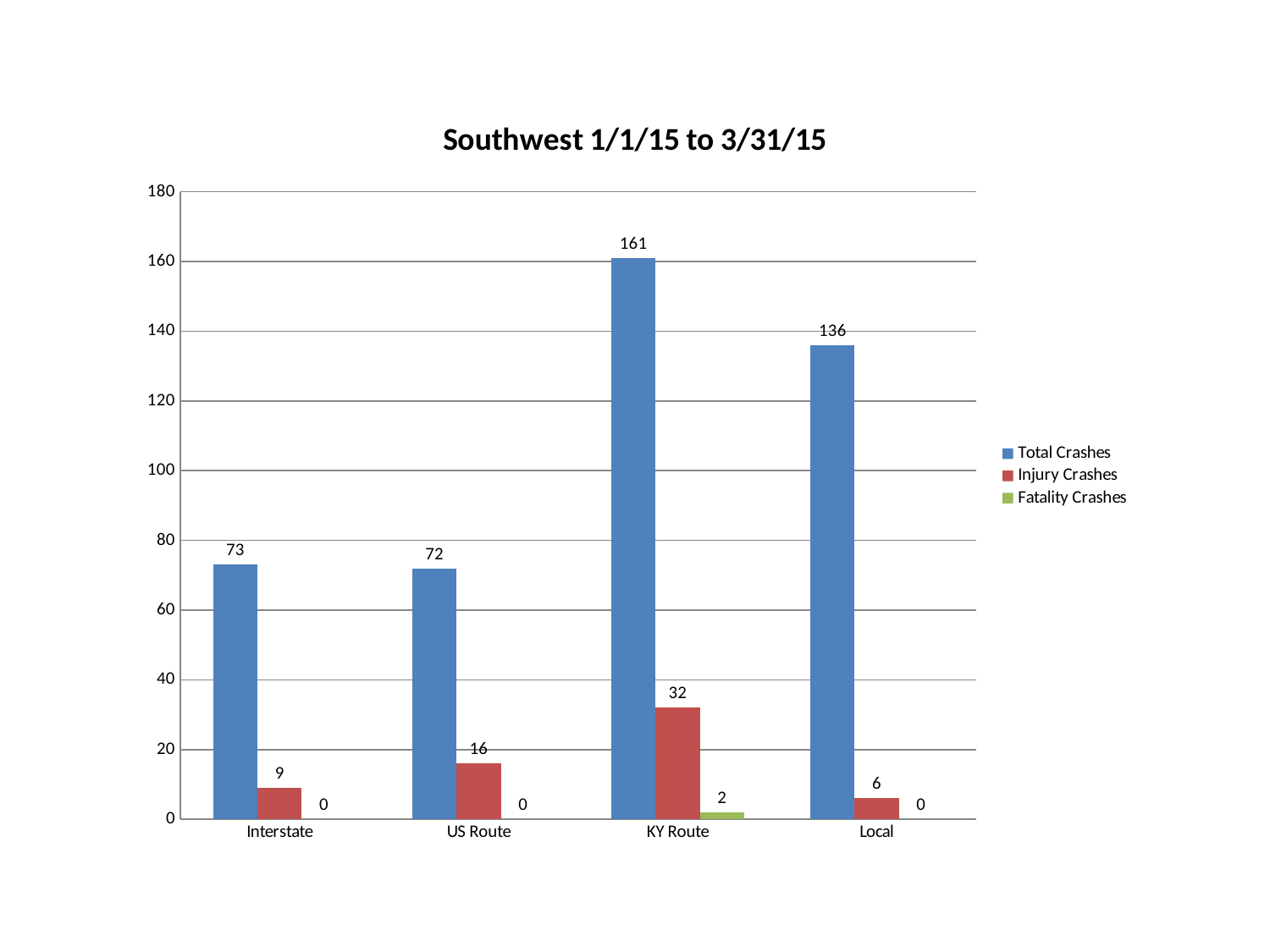
What is the value of Fatality Crashes for KY Route? 2 What kind of chart is shown on the slide? bar chart What is the title of the chart? Southwest 1/1/15 to 3/31/15 How many categories are shown on the x axis? 4 How many series does the legend list? 3 Is the value of Total Crashes for Local greater or less than 120? greater Which category has the highest Total Crashes? KY Route What is the difference between Total Crashes for KY Route and Local? 25 Which category has the lowest Injury Crashes? Local What is the value of Injury Crashes for US Route? 16 What is the value of Total Crashes for KY Route? 161 Which is larger, Injury Crashes for Interstate or Injury Crashes for US Route? US Route